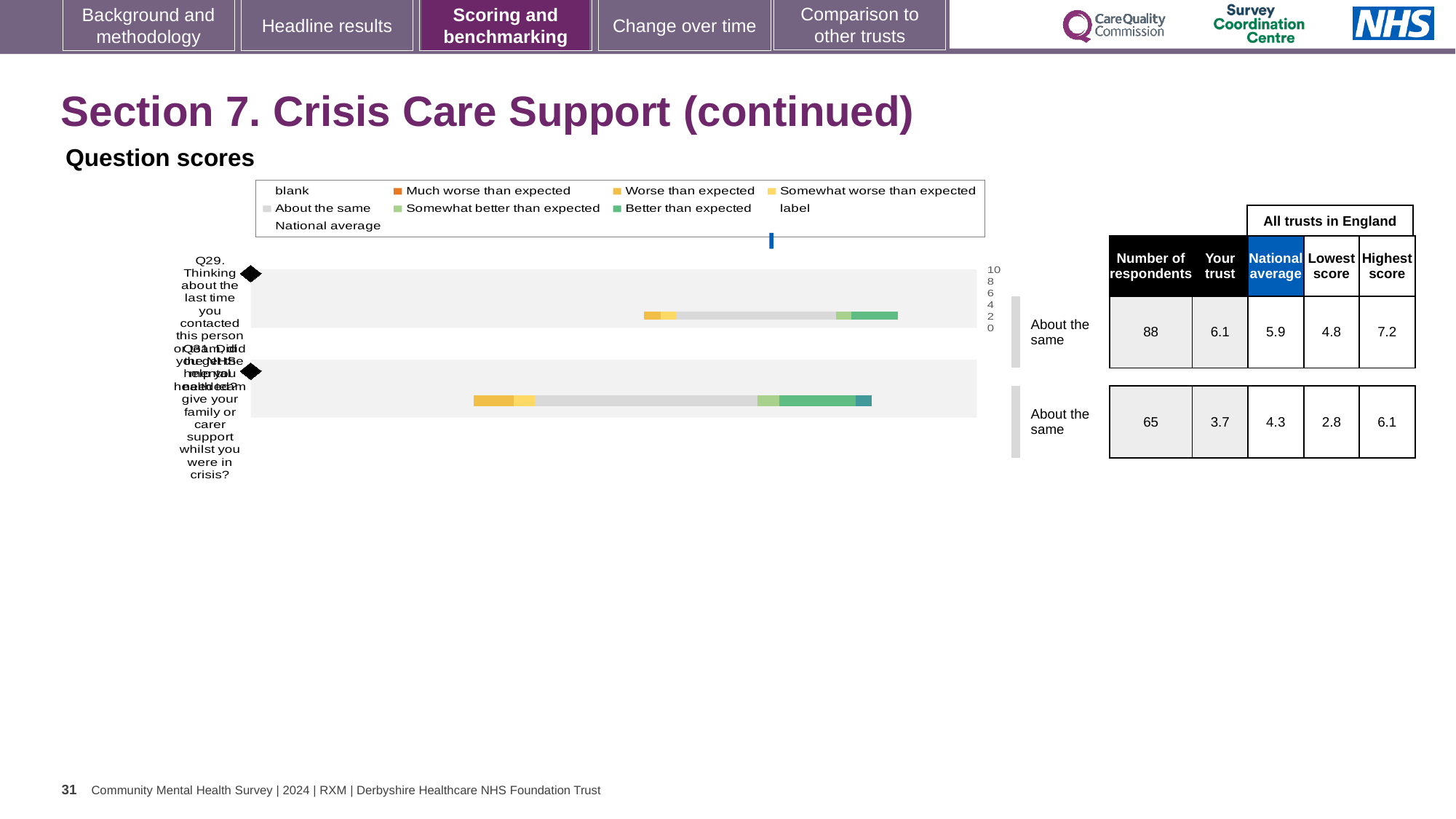
What is the difference between the national average and the 'Your trust' score for the second row (Q31)? 0.6 For the second row (Q31), which is larger: the 'Your trust' score or the national average? National average In the table next to the chart, how many respondents are listed for the second row (Q31)? 65 In the table next to the chart, what is the highest score among all trusts in England for the second row (Q31)? 6.1 In the table next to the chart, what is the 'Your trust' score for the second row (Q31)? 3.7 In the table next to the chart, what is the national average for the first row (Q29)? 5.9 What kind of chart is used to show the question scores on this slide? bar chart How many questions (rows) are plotted in the question scores chart? 2 What is the difference between the highest score and the lowest score for the first row (Q29)? 2.4 For the first row (Q29), which is larger: the 'Your trust' score or the national average? Your trust What benchmark category is shown beside the chart for both Q29 and Q31? About the same In the table next to the chart, what is the 'Your trust' score for the first row (Q29)? 6.1